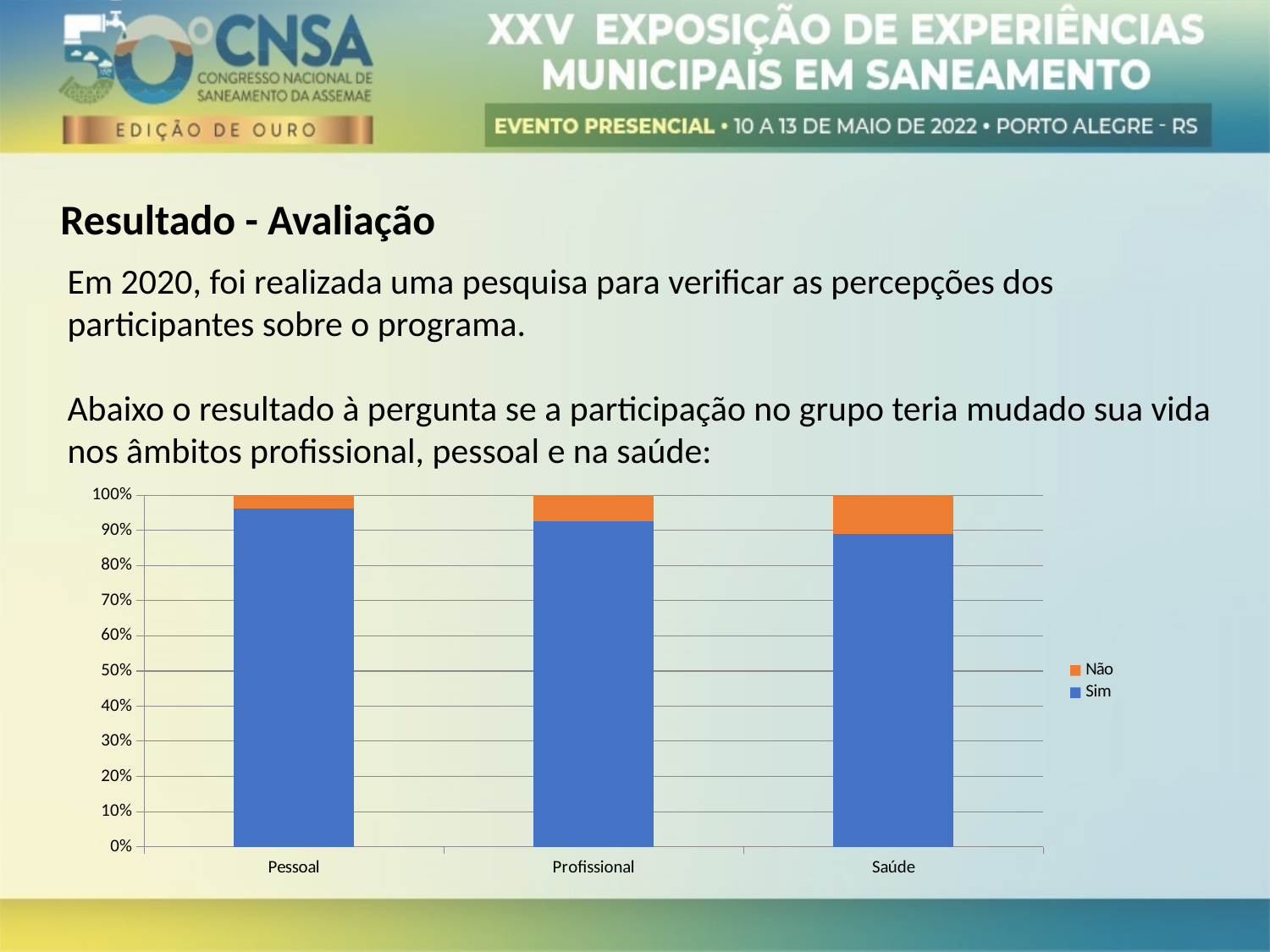
Which category has the largest share of 'Não' responses? Saúde How many series does the chart legend list? 2 Which is larger: the 'Sim' share for Pessoal or for Saúde? Pessoal Is the 'Sim' share for Pessoal greater or less than 90%? greater Which series are listed in the chart legend? Não and Sim Which colour represents the 'Sim' series in the chart? Blue Which category has the highest share of 'Sim' responses? Pessoal What kind of chart is shown on the slide? Stacked bar chart How many categories are shown on the x axis of the chart? 3 Which category has the lowest share of 'Sim' responses? Saúde Is the 'Sim' share for Saúde greater or less than 90%? less Does the 'Sim' share rise or fall from Pessoal to Saúde along the x axis? Fall